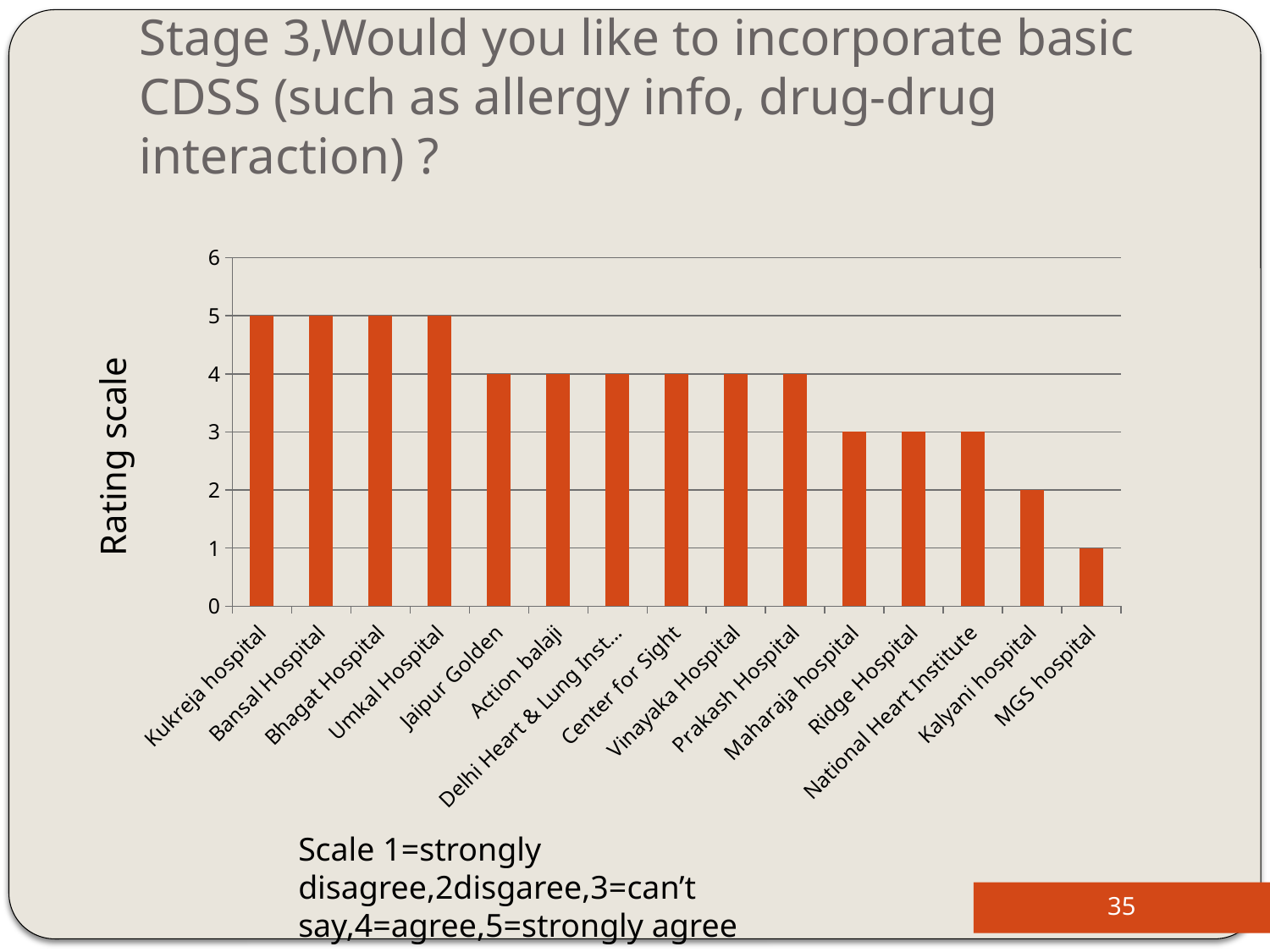
Which has a higher rating, Bansal Hospital or Ridge Hospital? Bansal Hospital What is the rating for Ridge Hospital? 3 What is the difference between the ratings for Kukreja hospital and MGS hospital? 4 Which hospital has the lowest rating? MGS hospital What is the label on the vertical axis of the chart? Rating scale What is the rating for Kalyani hospital? 2 What kind of chart is shown on the slide? Bar chart Do the ratings rise or fall from left to right along the x axis? Fall How many hospitals are shown on the chart? 15 What is the difference between the ratings for Jaipur Golden and Kalyani hospital? 2 What is the rating for Jaipur Golden? 4 What is the rating for Kukreja hospital? 5